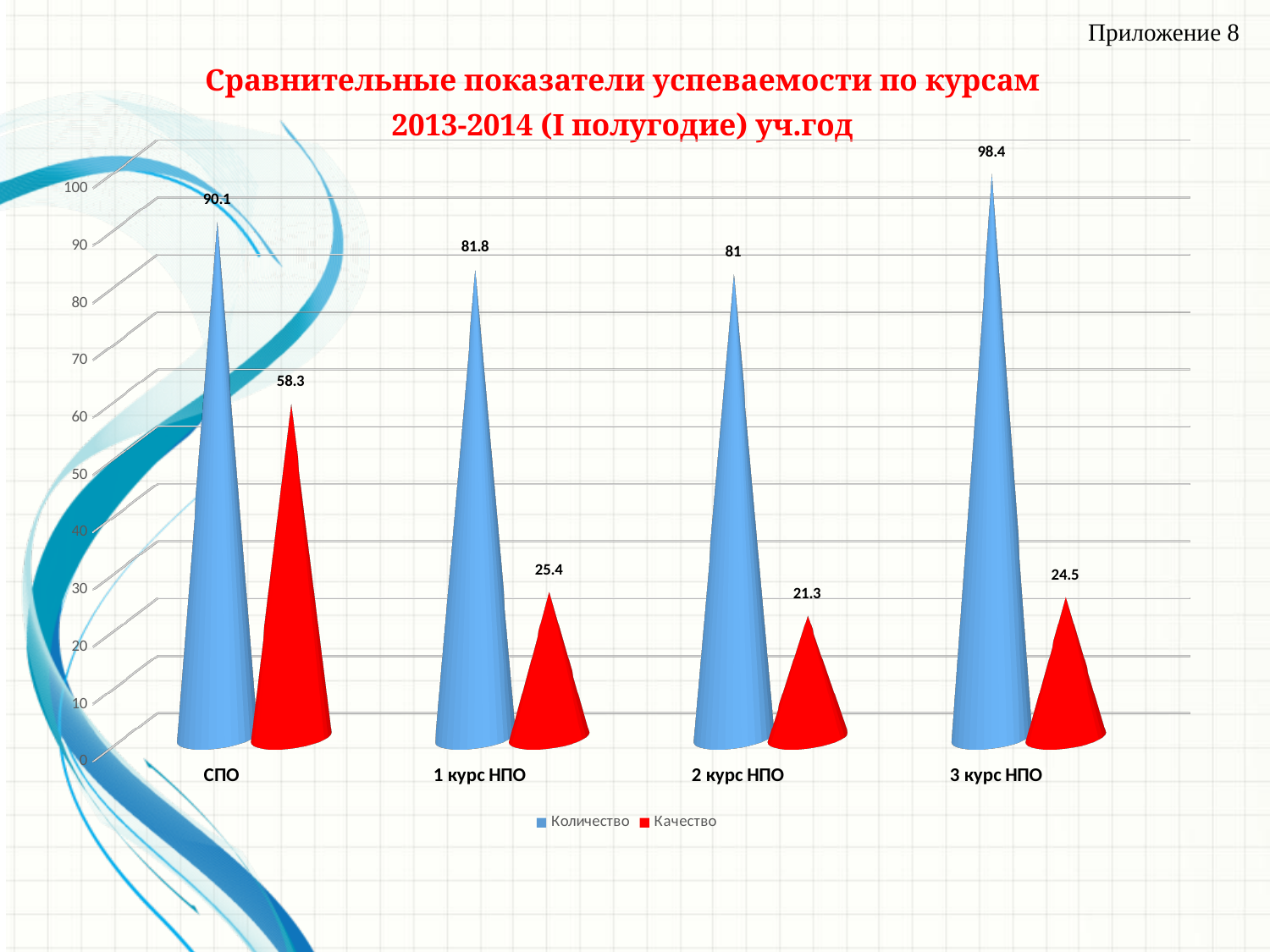
What is the Количество value for 3 курс НПО? 98.4 What is the difference between the Количество and Качество values for СПО? 31.8 What is the Количество value for 1 курс НПО? 81.8 How many series does the legend list? 2 What is the Качество value for 2 курс НПО? 21.3 Which is larger, the Качество value for 1 курс НПО or for 3 курс НПО? 1 курс НПО Which category has the lowest Качество value? 2 курс НПО Which category has the highest Количество value? 3 курс НПО Which colour represents the Качество series? Red What is the Качество value for СПО? 58.3 How many categories are shown on the x axis? 4 What kind of chart is shown on the slide? Bar chart